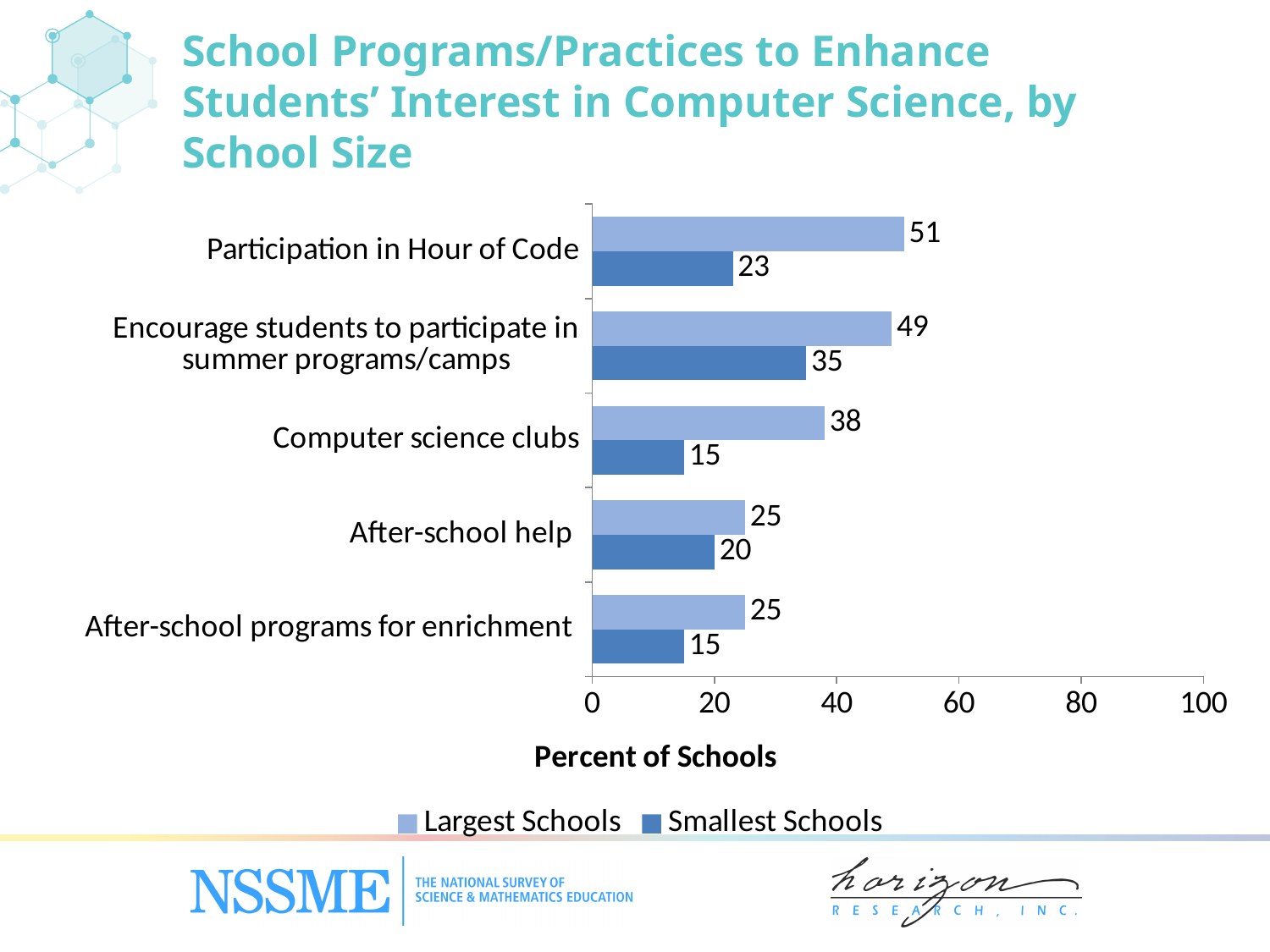
What is the value for Smallest Schools for Encourage students to participate in summer programs/camps? 35 What is the label of the horizontal axis? Percent of Schools How many categories are shown on the chart? 5 What is the value for Smallest Schools for Computer science clubs? 15 What is the difference between the Largest Schools and Smallest Schools values for After-school help? 5 Which category has the highest value for Smallest Schools? Encourage students to participate in summer programs/camps Which is larger for Computer science clubs: the Largest Schools value or the Smallest Schools value? Largest Schools What is the difference between the Largest Schools and Smallest Schools values for Participation in Hour of Code? 28 Which category has the highest value for Largest Schools? Participation in Hour of Code How many series does the legend list? 2 What kind of chart is shown on the slide? Bar chart What is the value for Largest Schools for Participation in Hour of Code? 51